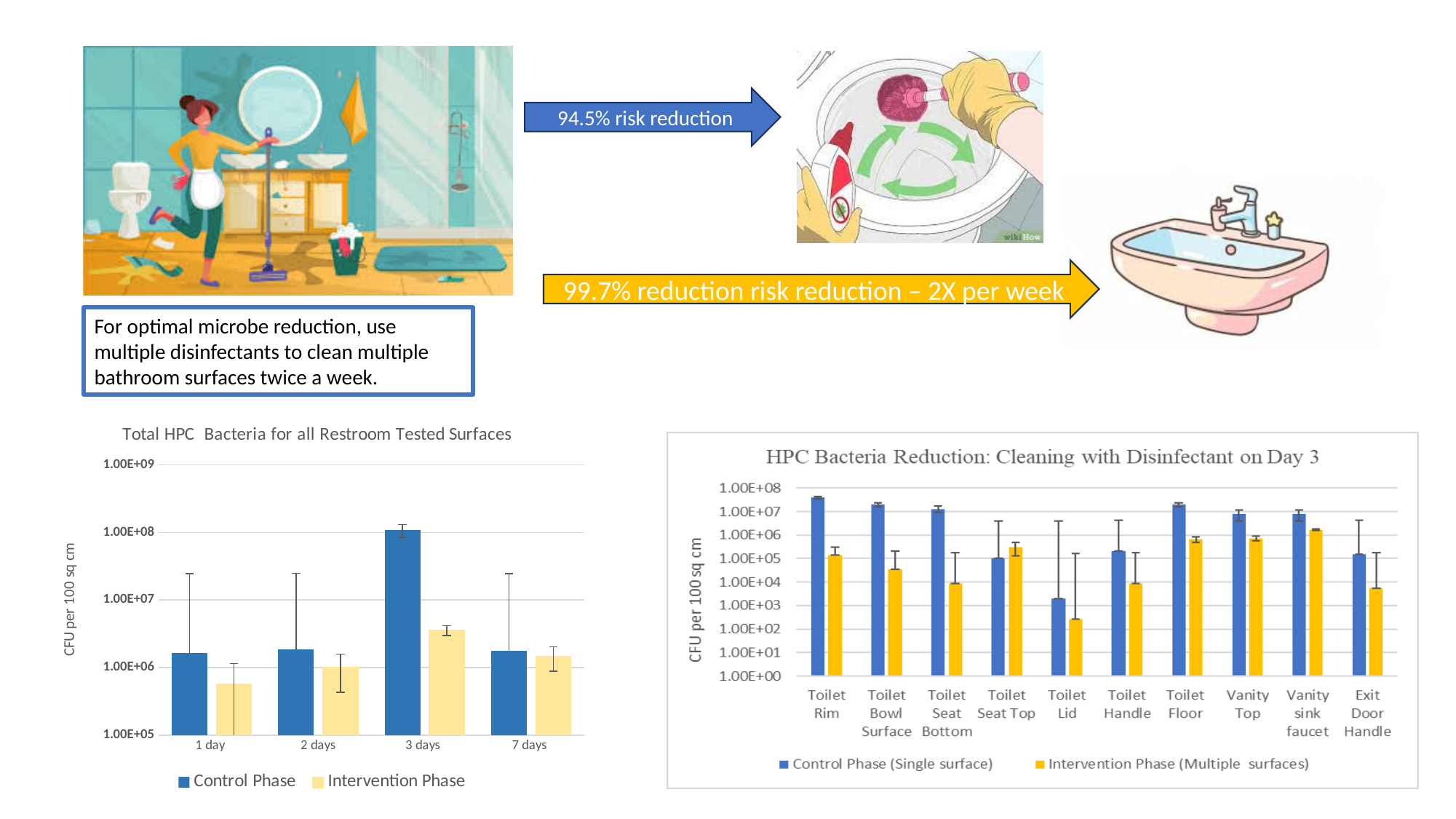
In the 'HPC Bacteria Reduction: Cleaning with Disinfectant on Day 3' chart, is the Intervention Phase value for Toilet Lid greater or less than 1.00E+03? less In the 'Total HPC Bacteria for all Restroom Tested Surfaces' chart, is the Control Phase value for 1 day greater or less than 1.00E+07? less In the 'Total HPC Bacteria for all Restroom Tested Surfaces' chart, which is larger at 3 days: Control Phase or Intervention Phase? Control Phase In the 'Total HPC Bacteria for all Restroom Tested Surfaces' chart, is the Intervention Phase value for 3 days greater or less than 1.00E+06? greater How many series does the legend of the 'Total HPC Bacteria for all Restroom Tested Surfaces' chart list? 2 In the 'Total HPC Bacteria for all Restroom Tested Surfaces' chart, at which category is the Control Phase value highest? 3 days How many surface categories are shown on the x axis of the 'HPC Bacteria Reduction: Cleaning with Disinfectant on Day 3' chart? 10 What are the two legend entries of the 'HPC Bacteria Reduction: Cleaning with Disinfectant on Day 3' chart? Control Phase (Single surface) and Intervention Phase (Multiple surfaces) In the 'HPC Bacteria Reduction: Cleaning with Disinfectant on Day 3' chart, which surface has the lowest Control Phase (Single surface) value? Toilet Lid What kind of chart is the chart titled 'Total HPC Bacteria for all Restroom Tested Surfaces'? Bar chart How many categories are shown on the x axis of the 'Total HPC Bacteria for all Restroom Tested Surfaces' chart? 4